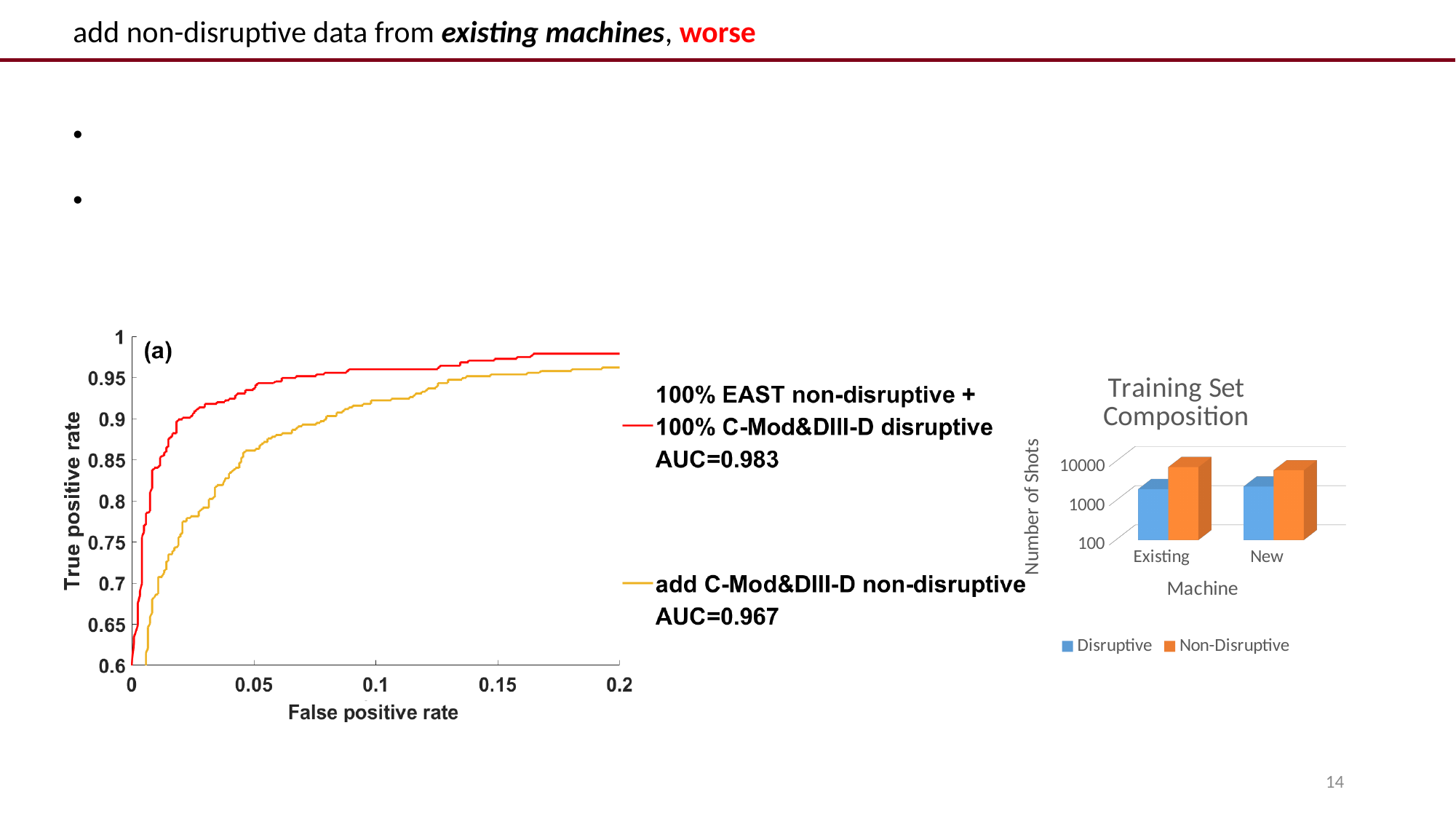
In the ROC chart on the left, what is the difference between the two AUC values? 0.016 In the ROC chart on the left, what is the AUC of the yellow curve (add C-Mod&DIII-D non-disruptive)? 0.967 How many series does the legend of the Training Set Composition chart list? 2 What kind of chart is the Training Set Composition chart? bar chart What is the y-axis title of the Training Set Composition chart? Number of Shots In the ROC chart on the left, what is the AUC of the red curve (100% EAST non-disruptive + 100% C-Mod&DIII-D disruptive)? 0.983 In the Training Set Composition chart, is the Non-Disruptive value for Existing machines greater or less than 1000? greater In the Training Set Composition chart, which is larger for Existing machines: Disruptive or Non-Disruptive? Non-Disruptive How many machine categories are shown on the x axis of the Training Set Composition chart? 2 In the Training Set Composition chart, which is larger for New machines: Disruptive or Non-Disruptive? Non-Disruptive What is the x-axis label of the ROC chart on the left? False positive rate In the Training Set Composition chart, is the Disruptive value for New machines greater or less than 1000? greater